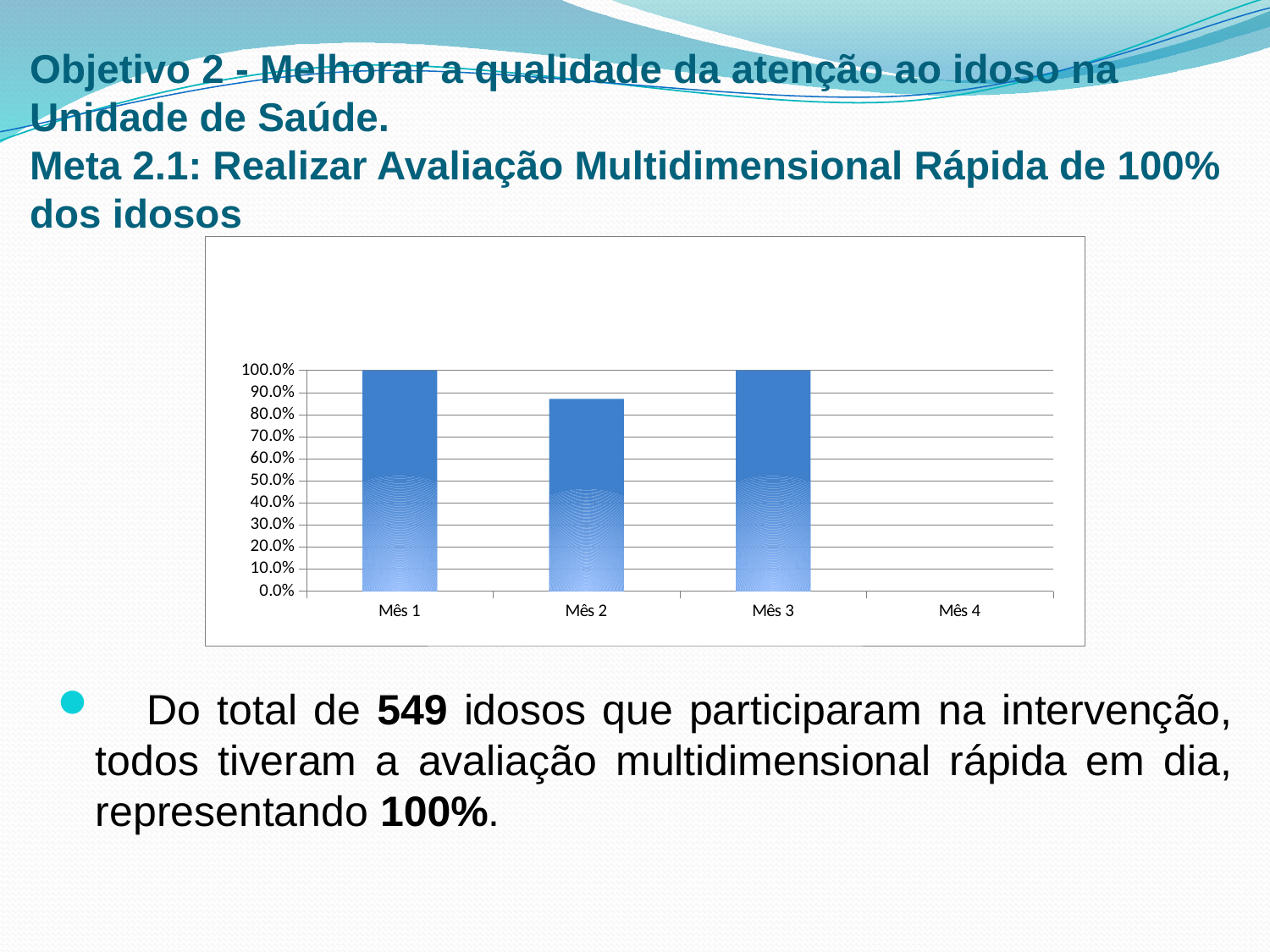
Which is larger, the value for Mês 2 or the value for Mês 3? Mês 3 What kind of chart is shown on the slide? bar chart What is the value for Mês 1 in the chart? 100.0% What is the highest value shown on the y axis of the chart? 100.0% Is the value for Mês 2 greater or less than 90.0%? less Which is larger, the value for Mês 1 or the value for Mês 2? Mês 1 Does the value rise or fall from Mês 1 to Mês 2? fall Is the value for Mês 2 greater or less than 80.0%? greater What is the value for Mês 3 in the chart? 100.0% Is there a visible bar for Mês 4 in the chart? No Among Mês 1, Mês 2 and Mês 3, which month has the lowest value? Mês 2 How many month categories are shown on the x axis of the chart? 4